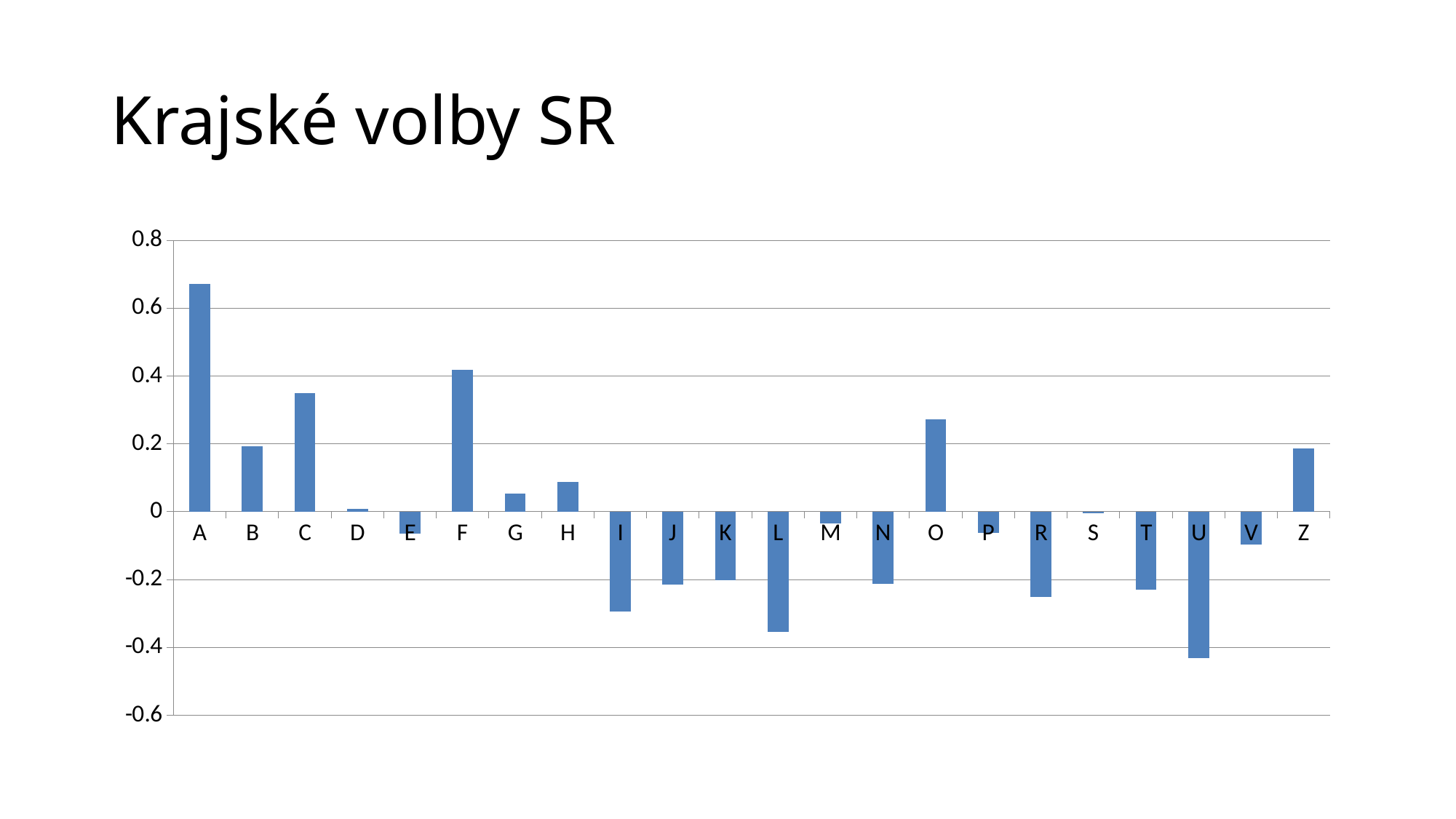
Is the value for L greater or less than -0.2? less What kind of chart is shown on the slide? bar chart Which has the larger value, C or O? C Is the value for C greater or less than 0.4? less Which has the larger value, A or F? A Is the value for A greater or less than 0.6? greater How many categories are plotted on the x axis? 22 What is the title of the slide? Krajské volby SR Which category has the lowest value? U Which category has the highest value? A